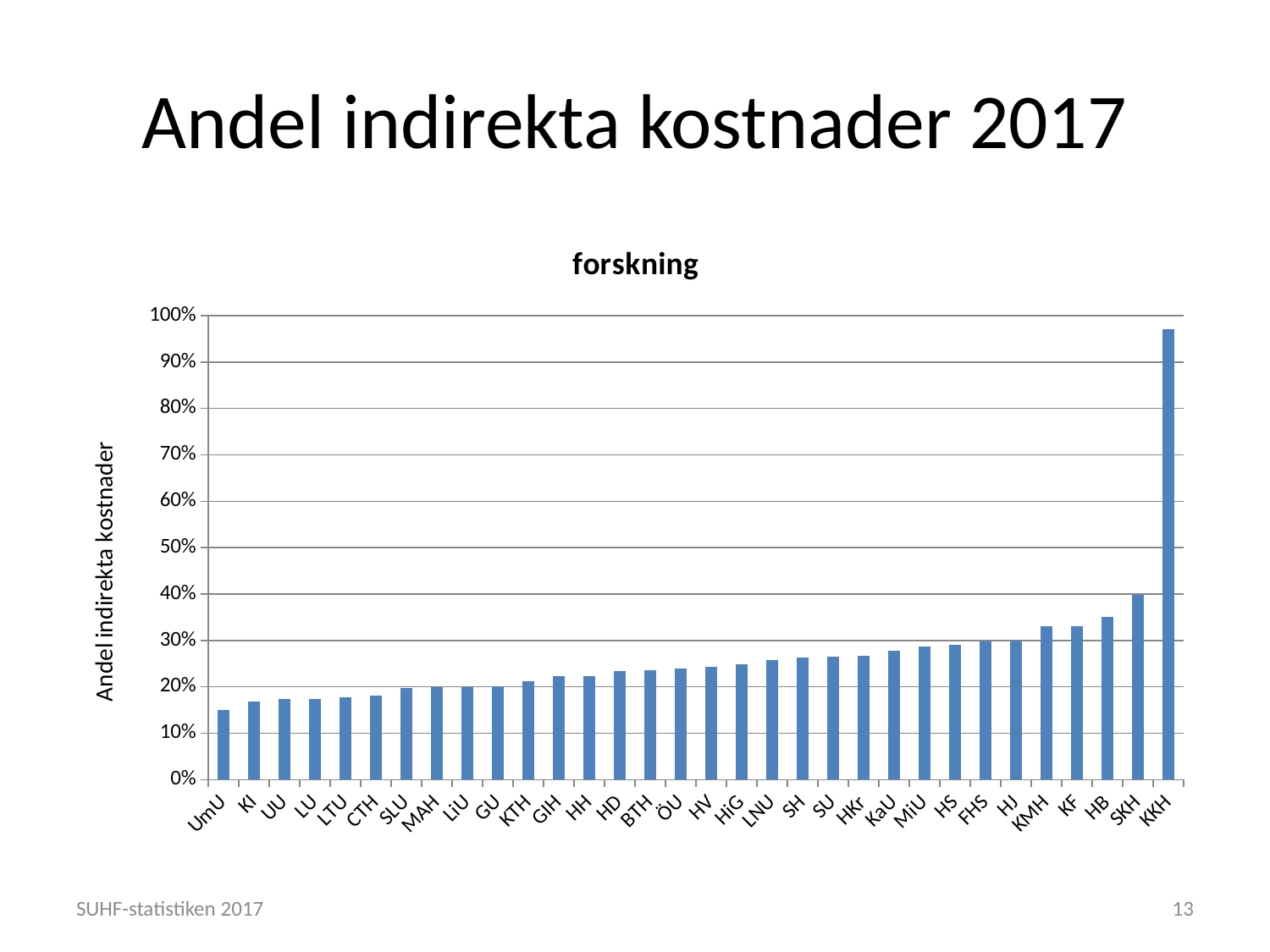
Is the value for HB greater or less than 30%? greater Which category has the lowest share of indirect costs in the 'forskning' chart? UmU Which is larger, the value for KKH or the value for SKH? KKH Is the value for UmU greater or less than 20%? less Is the value for KKH greater or less than 90%? greater What is the title shown above the chart? forskning Which is larger, the value for UmU or the value for HB? HB What kind of chart is shown on the slide? bar chart Which category has the highest share of indirect costs in the 'forskning' chart? KKH Do the bar values generally rise or fall from left to right along the x axis? rise